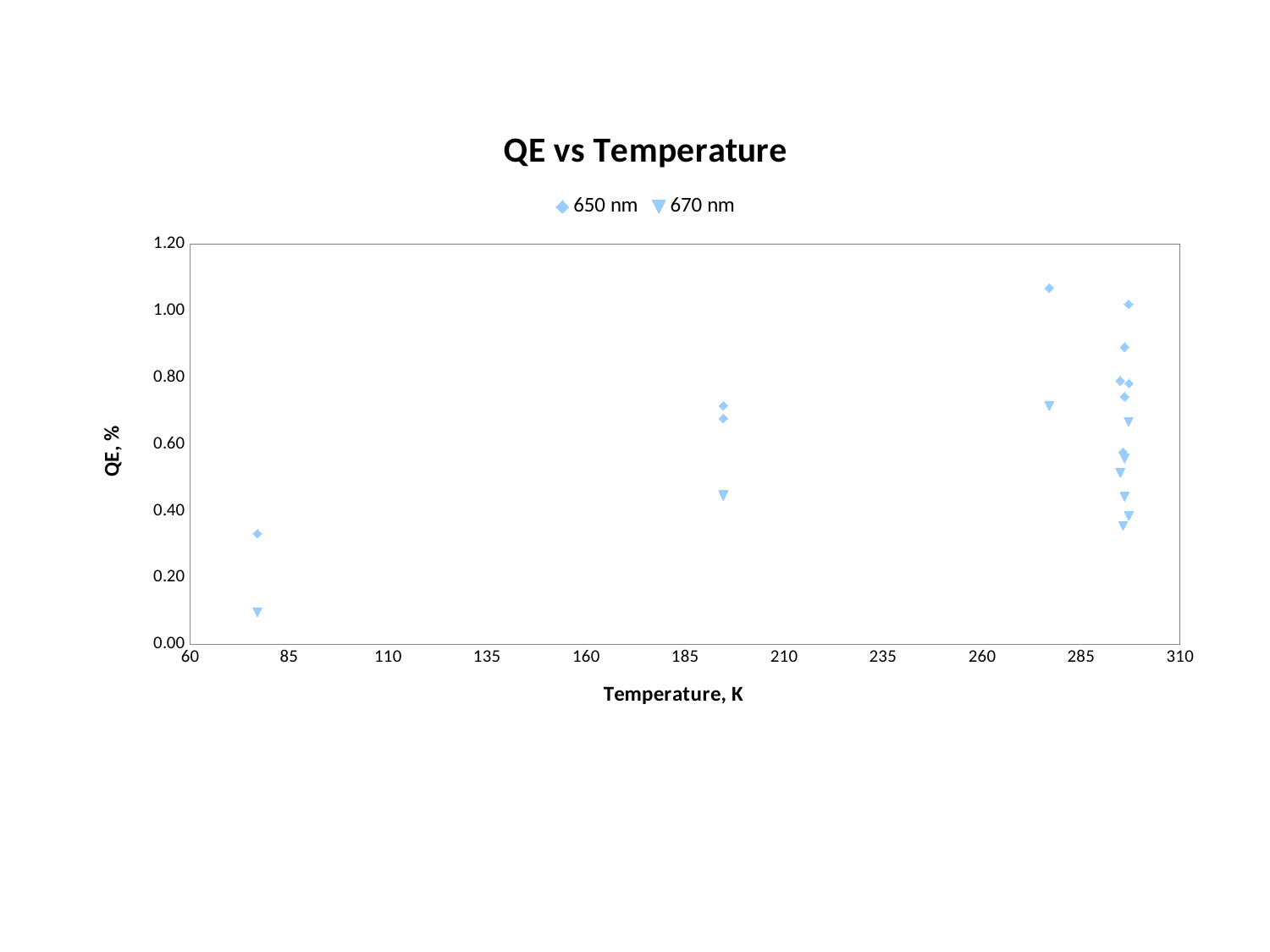
What kind of chart is shown on the slide? scatter chart What is the label of the x axis? Temperature, K Is the 670 nm value near 195 K greater or less than 0.60? less Near 277 K, which series has the higher QE, 650 nm or 670 nm? 650 nm Does QE generally rise or fall as temperature increases along the x axis? rise What is the title of the chart? QE vs Temperature How many series does the legend list? 2 Is the 670 nm value at the lowest temperature (around 77 K) greater or less than 0.20? less Is the 650 nm value near 277 K greater or less than 1.00? greater At the lowest temperature (around 77 K), which series has the higher QE, 650 nm or 670 nm? 650 nm